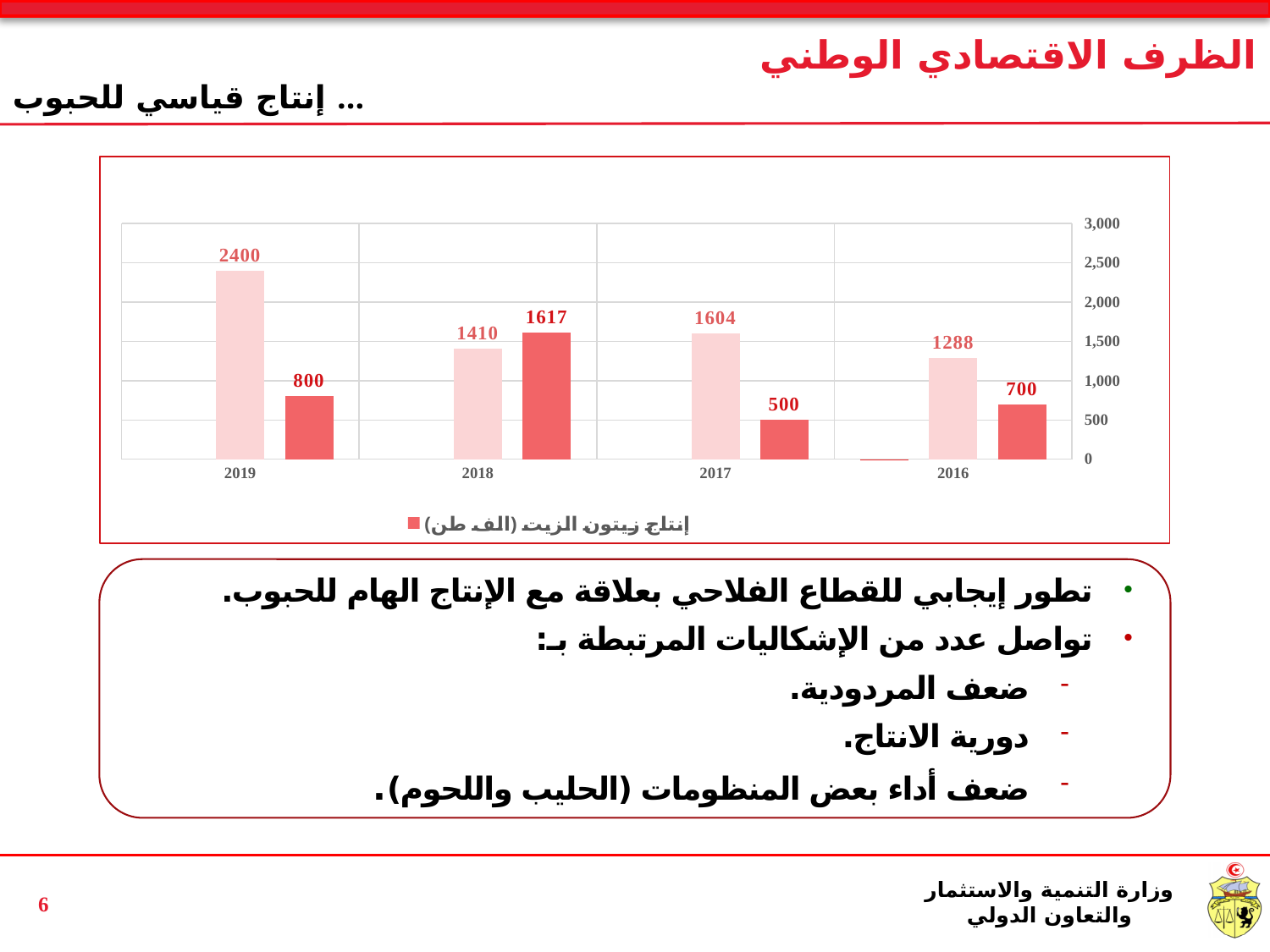
What legend entry is shown below the chart? إنتاج زيتون الزيت (الف طن) How many years are shown on the x axis of the chart? 4 What is the value of the light pink bar for 2016? 1288 What is the value of the light pink bar for 2019? 2400 What is the difference between the darker red bar values for 2016 and 2017? 200 What is the difference between the light pink bar and the darker red bar in 2019? 1600 What is the value of the darker red bar (إنتاج زيتون الزيت) for 2018? 1617 What type of chart is shown on the slide? bar chart In 2018, which is larger: the light pink bar or the darker red bar? the darker red bar In which year is the darker red bar (إنتاج زيتون الزيت) lowest? 2017 In which year is the light pink bar highest? 2019 What is the value of the darker red bar (إنتاج زيتون الزيت) for 2017? 500